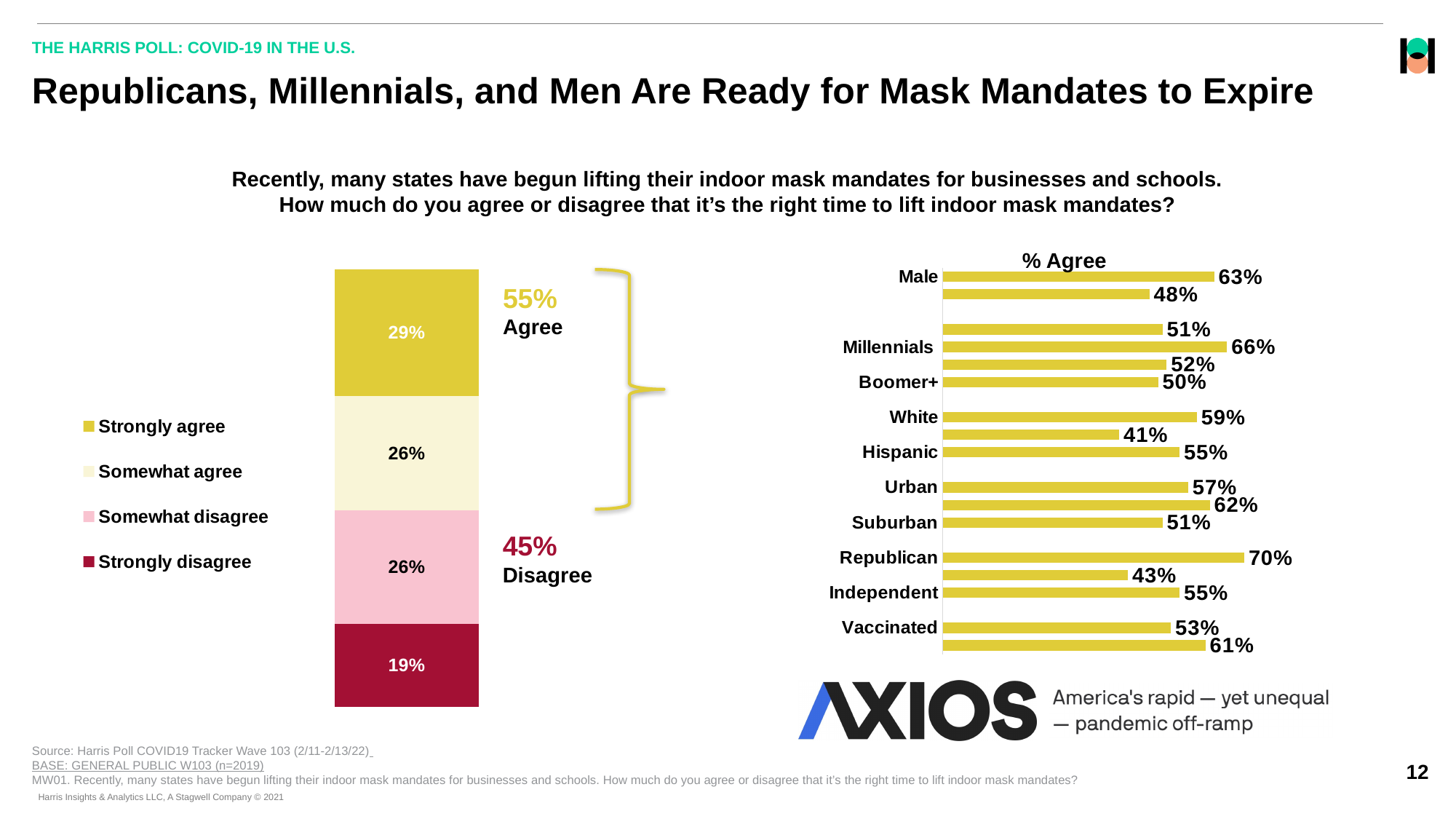
In the '% Agree' chart on the right, what is the value for Millennials? 66% In the stacked bar chart on the left, how many percentage points higher is Strongly agree than Strongly disagree? 10 percentage points In the '% Agree' chart on the right, what is the value for Boomer+? 50% In the stacked bar chart on the left, what is the combined share of respondents who agree (strongly plus somewhat)? 55% In the '% Agree' chart on the right, which labeled group has the highest value? Republican In the stacked bar chart on the left, what percentage of respondents strongly agree? 29% In the stacked bar chart on the left, how many categories does the legend list? 4 In the '% Agree' chart on the right, what is the difference between the values for Millennials and Boomer+? 16 percentage points In the '% Agree' chart on the right, which is larger, the value for Male or the value for White? Male What kind of chart is the chart on the left of the slide? Stacked bar chart In the '% Agree' chart on the right, what is the value for Republican? 70% In the stacked bar chart on the left, what percentage of respondents strongly disagree? 19%